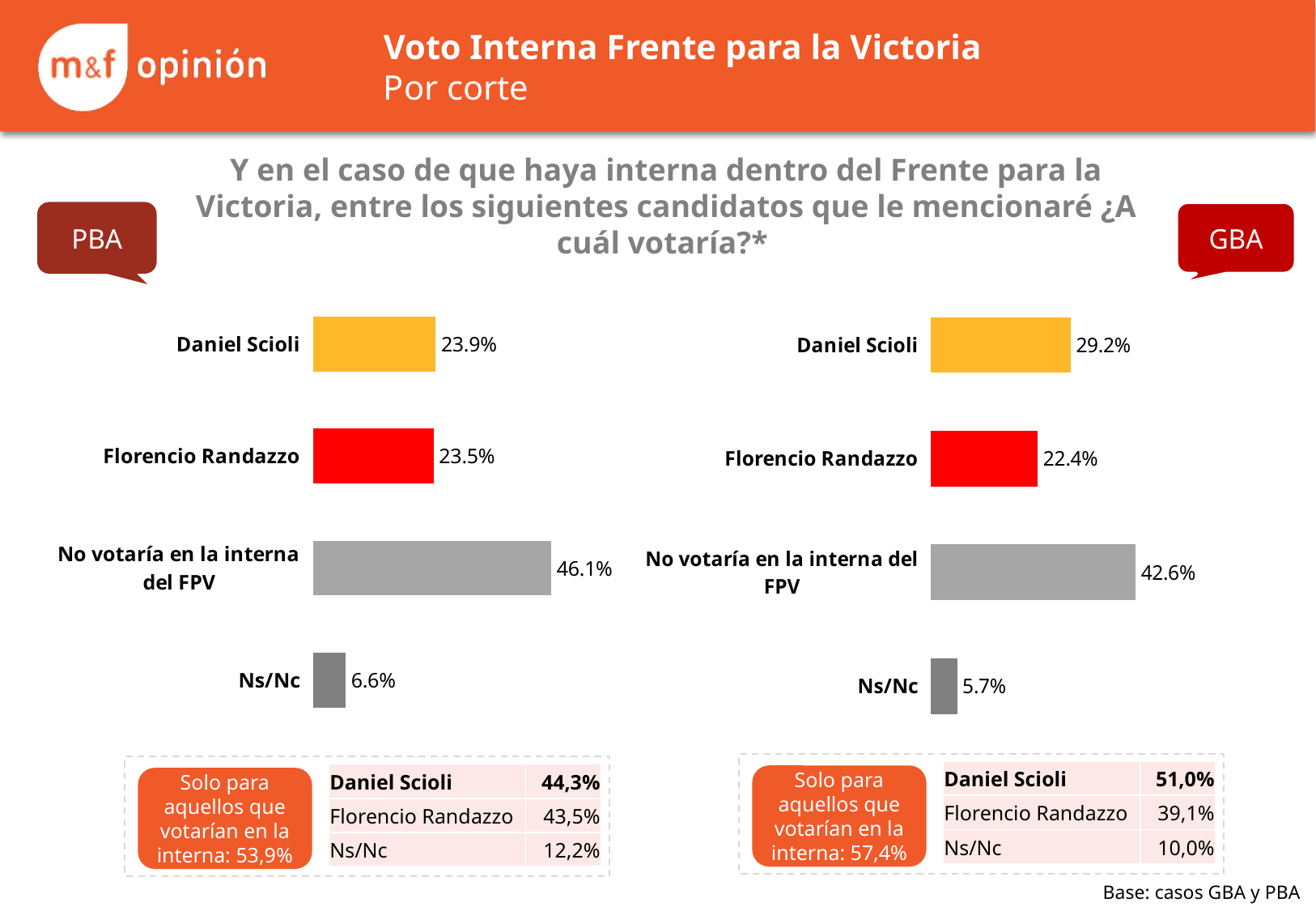
How many categories does the PBA chart show? 4 What kind of chart is the GBA chart? Bar chart In the PBA chart, which category has the highest value? No votaría en la interna del FPV In the PBA chart, what colour is the bar for Florencio Randazzo? Red In the GBA chart, which category has the lowest value? Ns/Nc In the GBA chart, what is the difference between Daniel Scioli and Florencio Randazzo? 6.8% In the PBA chart, what is the value for Ns/Nc? 6.6% In the PBA chart, what is the value for Daniel Scioli? 23.9% In the GBA chart, what is the value for Florencio Randazzo? 22.4% In the GBA chart, what is the value for 'No votaría en la interna del FPV'? 42.6% In the PBA chart, what is the difference between 'No votaría en la interna del FPV' and Ns/Nc? 39.5% Is the value for Daniel Scioli larger in the PBA chart or the GBA chart? GBA